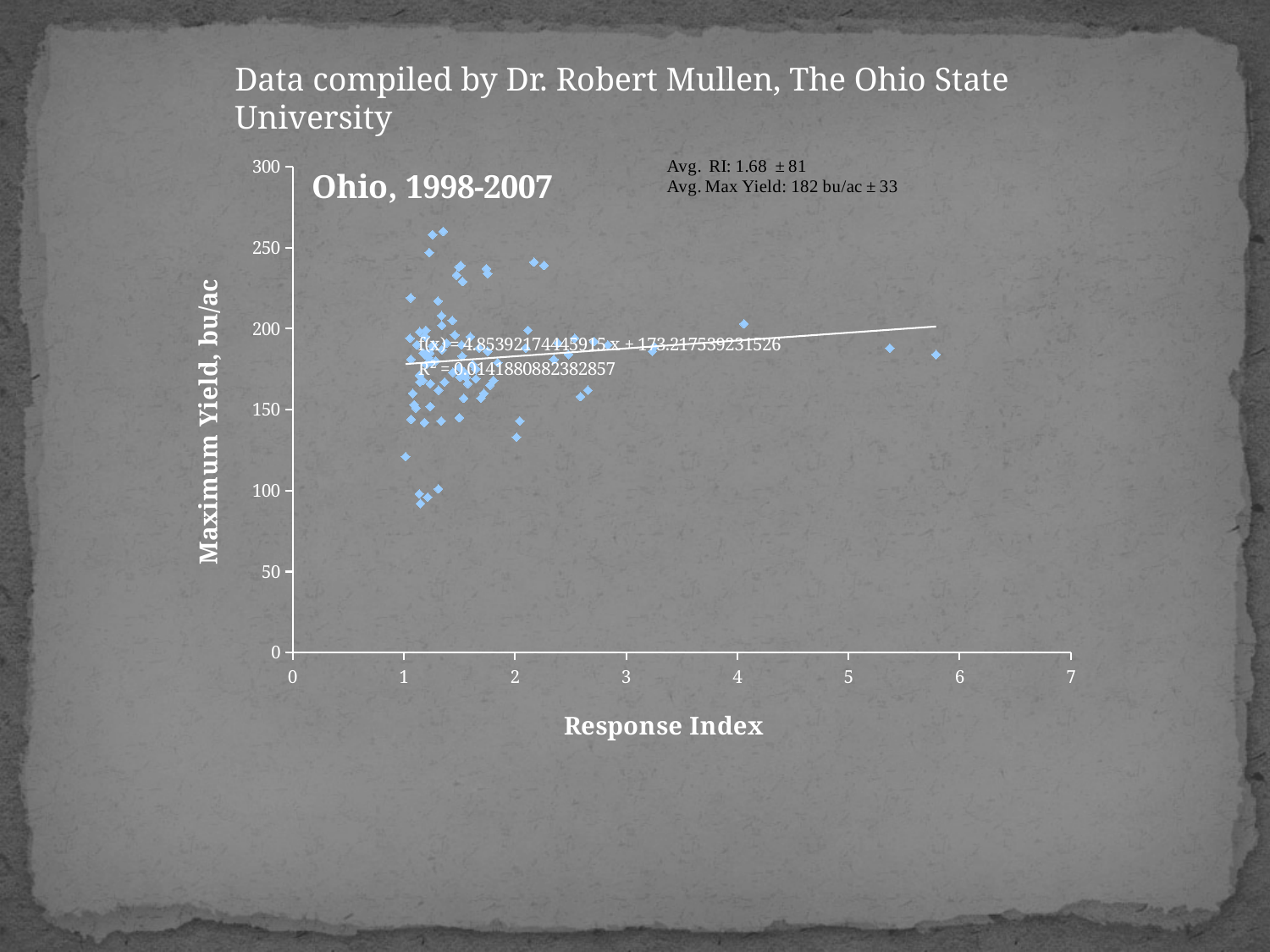
What R² value is printed on the chart? 0.0141880882382857 Does the fitted trendline rise or fall as Response Index increases? rises Is the Maximum Yield of the point with the highest Response Index greater or less than 150? greater Is the Response Index of the rightmost point greater or less than 5? greater Is the Maximum Yield of the highest point on the chart greater or less than 250? greater What average maximum yield is stated in the annotation on the chart? 182 bu/ac ± 33 What average RI is stated in the annotation on the chart? 1.68 ± 81 What is the label of the x axis? Response Index What kind of chart is shown on the slide? scatter plot What is the title of the chart? Ohio, 1998-2007